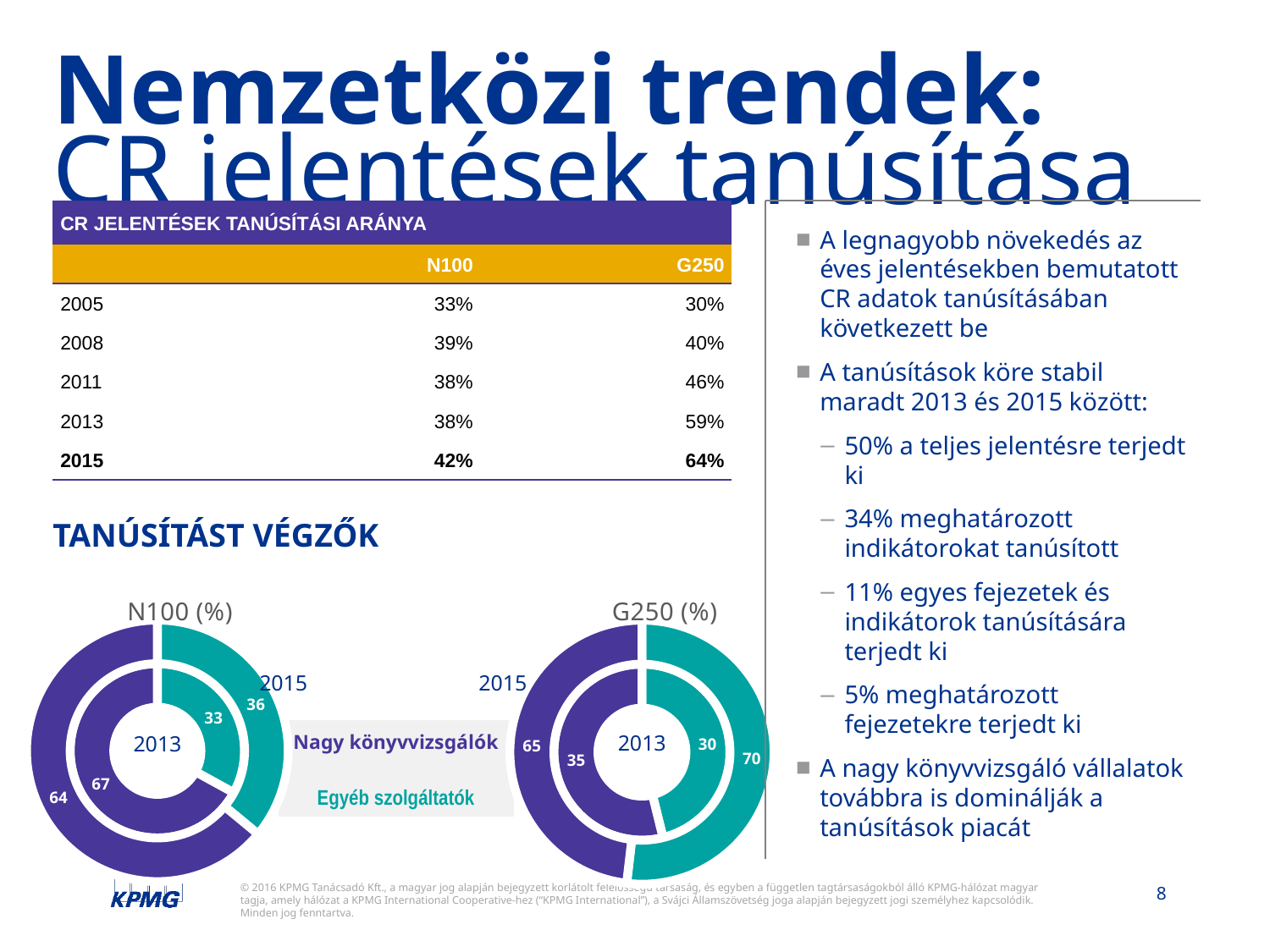
What kind of chart is used for the N100 (%) and G250 (%) charts under 'TANÚSÍTÁST VÉGZŐK'? Doughnut chart In the N100 (%) chart, what is the difference between Nagy könyvvizsgálók and Egyéb szolgáltatók in 2013? 34 In the N100 (%) chart, what is the value for Nagy könyvvizsgálók in 2013? 67 In the N100 (%) chart, did the share of Nagy könyvvizsgálók rise or fall from 2013 to 2015? Fall How many entries does the legend between the N100 (%) and G250 (%) charts list? 2 In the N100 (%) chart, what is the value for Nagy könyvvizsgálók in 2015? 64 In the G250 (%) chart, which is larger in 2015: Nagy könyvvizsgálók or Egyéb szolgáltatók? Egyéb szolgáltatók How many years (rings) does each doughnut chart show? 2 In the N100 (%) chart, what is the value for Egyéb szolgáltatók in 2015? 36 What are the two legend entries shown between the N100 (%) and G250 (%) charts? Nagy könyvvizsgálók, Egyéb szolgáltatók In the N100 (%) chart, which is larger in 2015: Nagy könyvvizsgálók or Egyéb szolgáltatók? Nagy könyvvizsgálók In the N100 (%) chart, what is the value for Egyéb szolgáltatók in 2013? 33